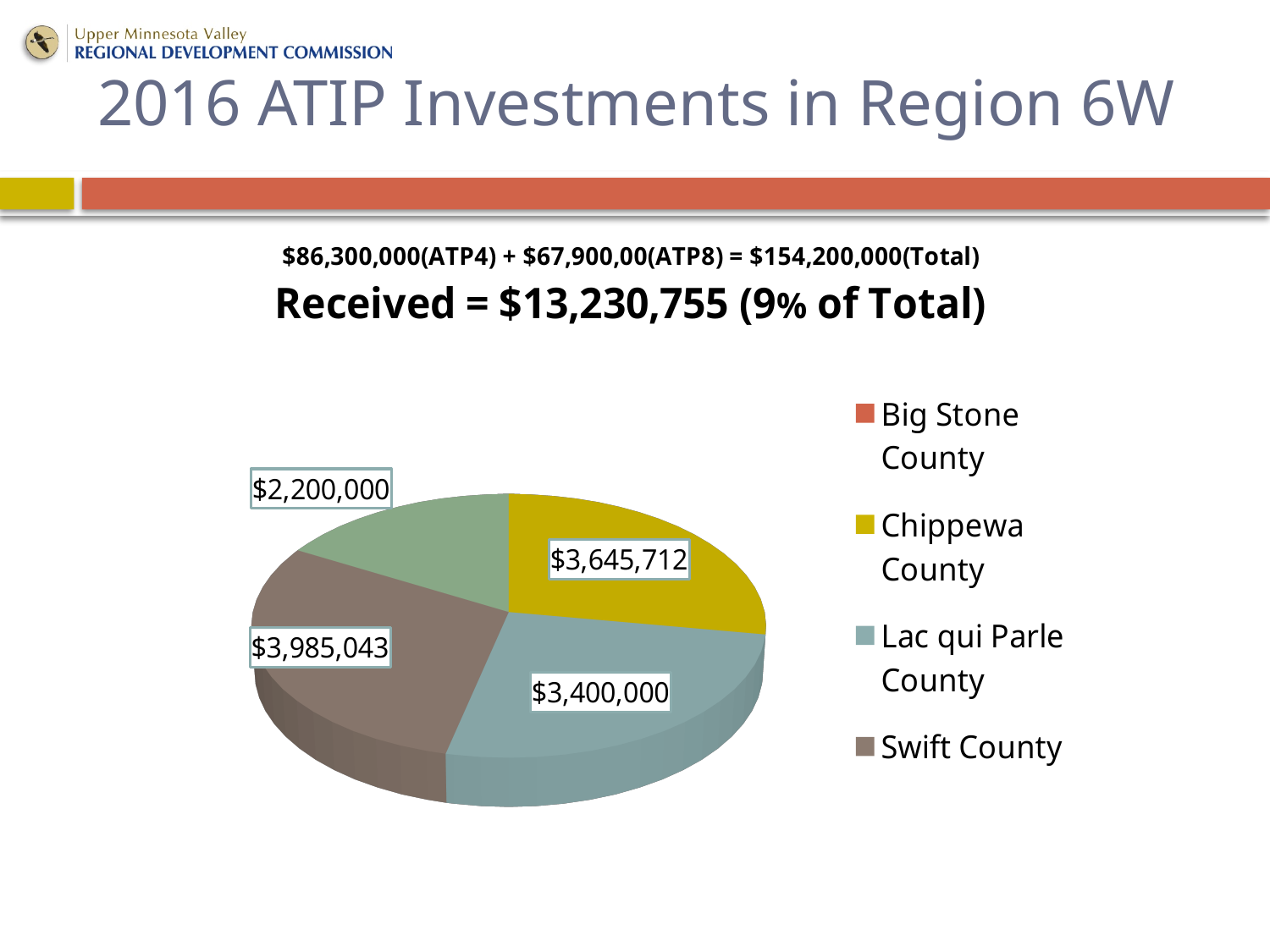
How many slices does the pie chart have? 4 What is the value of the largest slice in the pie chart? $3,985,043 How many entries does the legend of the pie chart list? 4 What is the value of the smallest slice in the pie chart? $2,200,000 What is the total of all four slices in the pie chart? $13,230,755 Which county is listed last in the legend of the pie chart? Swift County What kind of chart is shown on the slide? pie chart What is the value shown for Swift County in the pie chart? $3,985,043 What is the value shown for Chippewa County in the pie chart? $3,645,712 What is the value shown for Lac qui Parle County in the pie chart? $3,400,000 What is the difference between the largest slice ($3,985,043) and the smallest slice ($2,200,000) in the pie chart? $1,785,043 Which is larger in the pie chart, the slice labelled $3,645,712 or the slice labelled $3,400,000? $3,645,712